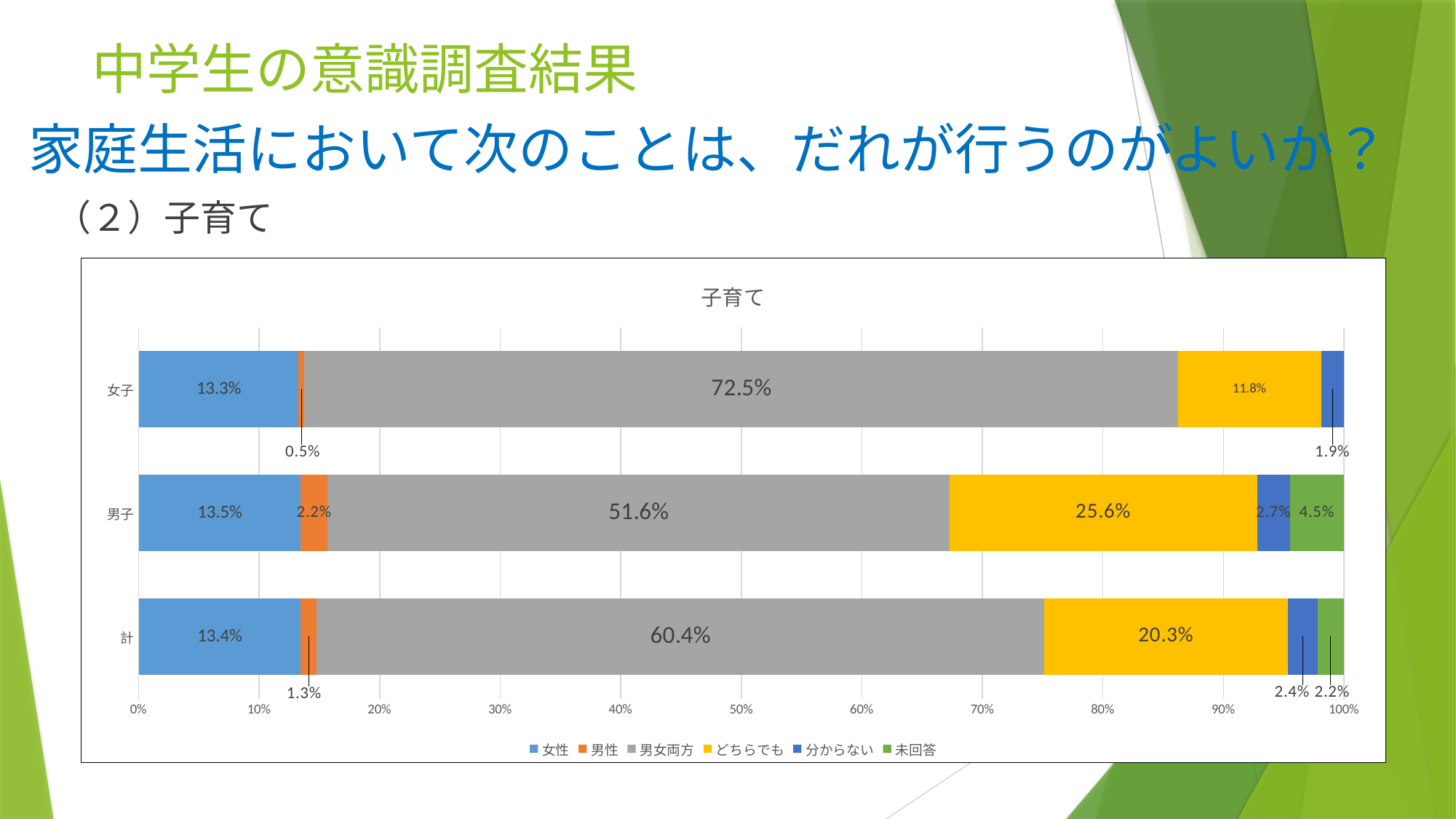
Which category has the lowest どちらでも value? 女子 Which is larger, the 分からない value for 男子 or for 計? 男子 What is the 未回答 value for 男子? 4.5% What is the difference between the 男女両方 values for 女子 and 男子? 20.9% What type of chart is shown on the slide? Stacked bar chart What is the 男性 value for 計? 1.3% How many series does the legend list? 6 How many categories (bars) are shown in the chart? 3 Which category has the highest 男女両方 value? 女子 What is the 男女両方 value for 女子? 72.5% What is the どちらでも value for 男子? 25.6% What is the title of the chart? 子育て